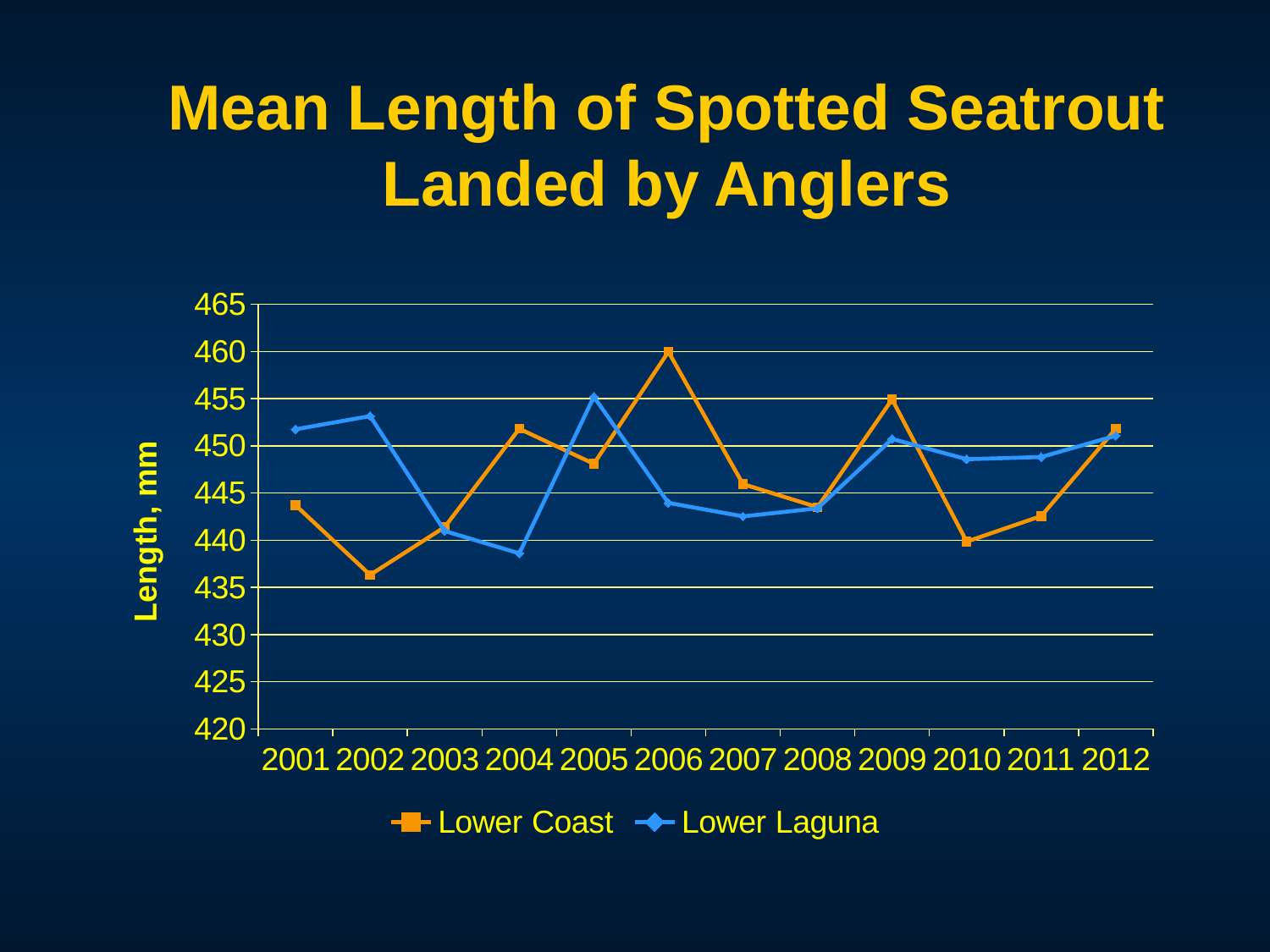
In which year does the Lower Coast series reach its highest value? 2006 Is the Lower Coast value for 2002 greater or less than 440? less How many series does the legend list? 2 In 2006, which series has the larger value, Lower Coast or Lower Laguna? Lower Coast In which year does the Lower Laguna series reach its highest value? 2005 What is the label on the y axis? Length, mm Is the Lower Laguna value for 2001 greater or less than 450? greater In which year does the Lower Coast series reach its lowest value? 2002 In which year does the Lower Laguna series reach its lowest value? 2004 In 2010, which series has the larger value, Lower Coast or Lower Laguna? Lower Laguna How many years are plotted along the x axis? 12 What kind of chart is shown on the slide? Line chart